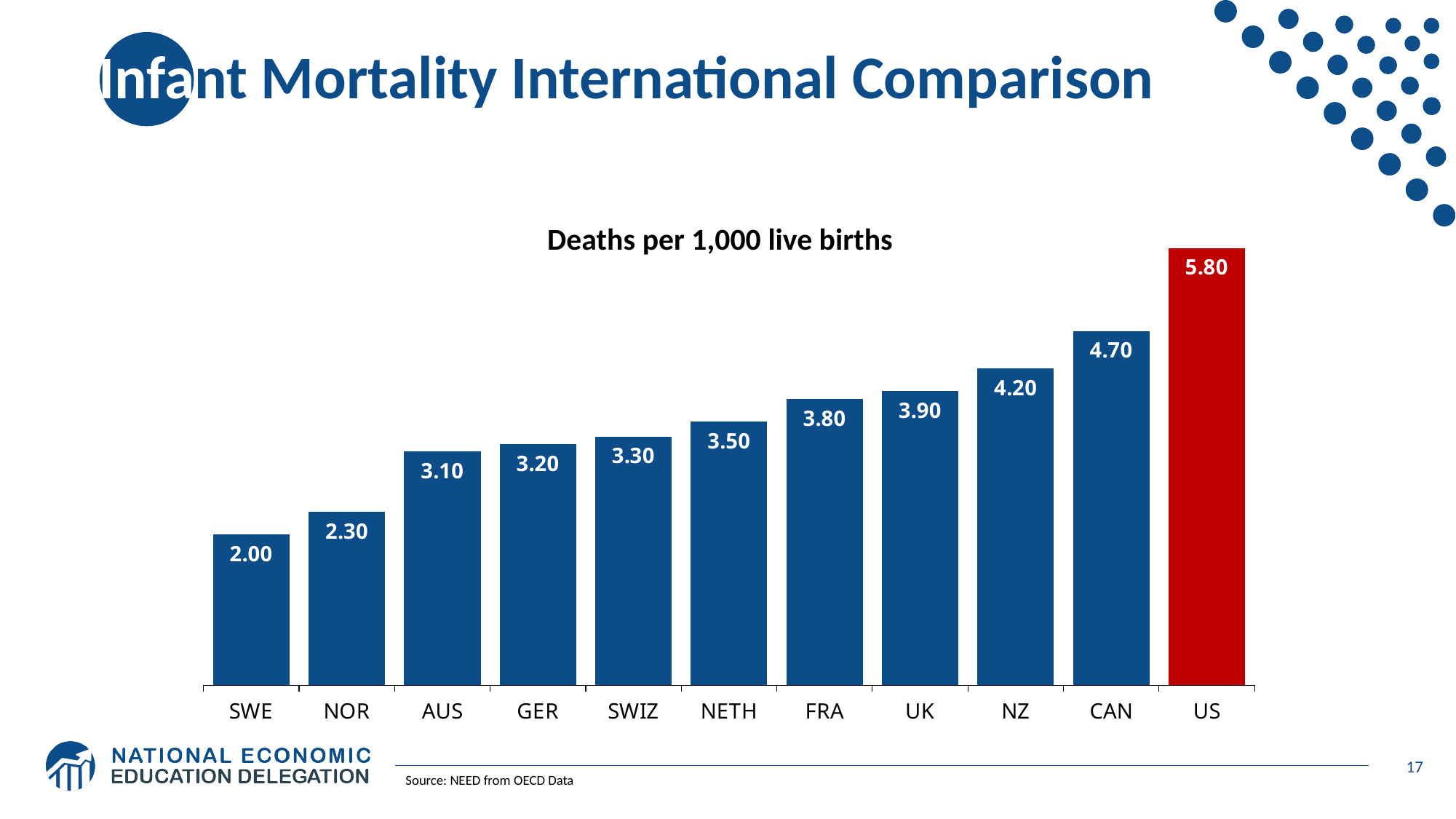
What is the title of the chart? Deaths per 1,000 live births Which has a higher value, FRA or UK? UK Which country has the highest infant mortality rate in the chart? US What kind of chart is shown on the slide? Bar chart How many countries are shown in the chart? 11 What is the value for NETH in the chart? 3.50 Which country has the lowest infant mortality rate in the chart? SWE What is the value for GER in the chart? 3.20 What is the value for the US in the chart? 5.80 What is the difference between the values for the US and SWE? 3.80 Do the values rise or fall from left to right along the x axis? Rise What is the difference between the values for CAN and NZ? 0.50